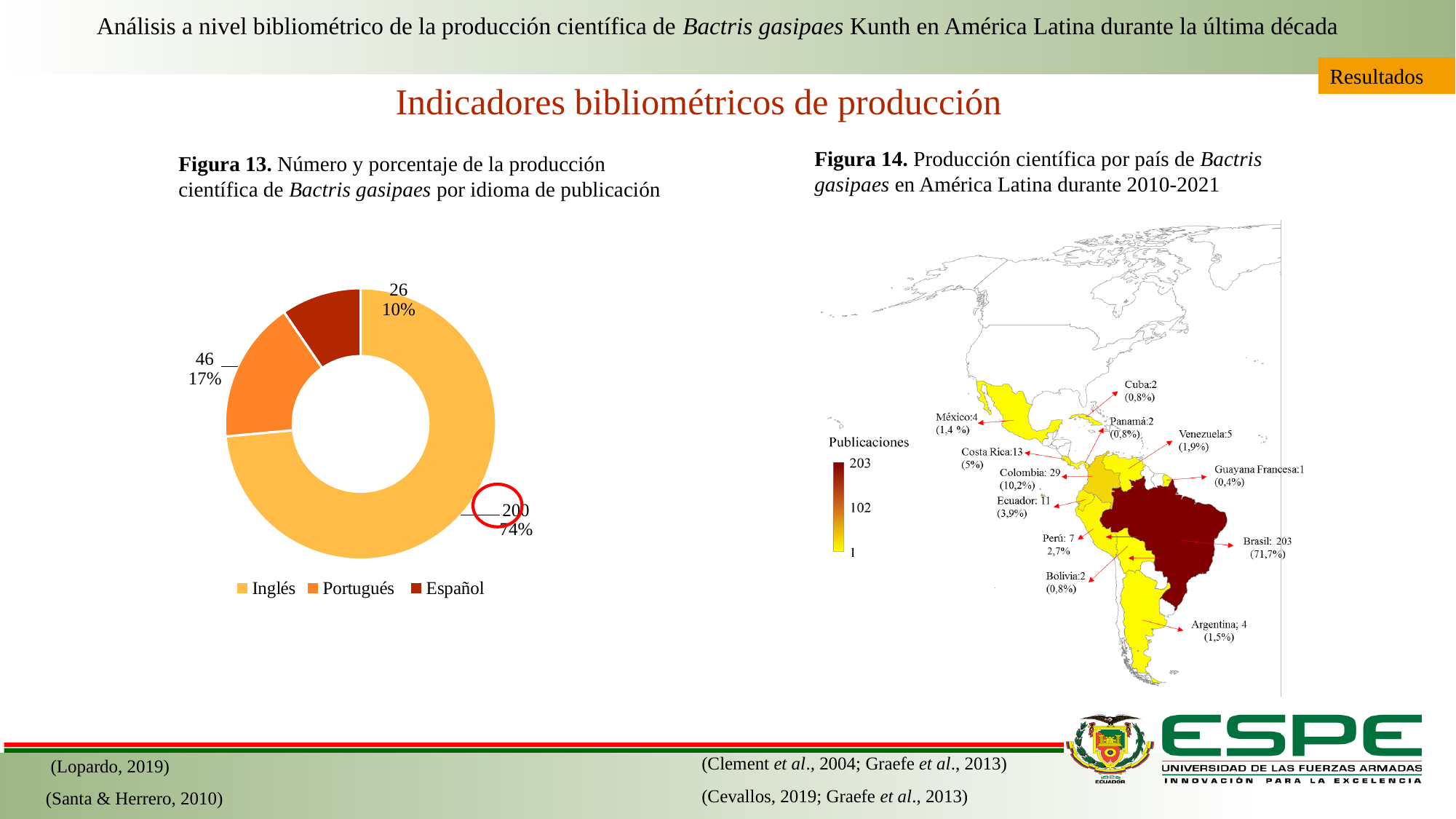
In Figura 13 (the donut chart), which language has the smallest number of publications? Español In Figura 13 (the donut chart), how many publications are in Español? 26 In Figura 13 (the donut chart), how many publications are in Inglés? 200 In Figura 13 (the donut chart), which has more publications, Portugués or Español? Portugués What type of chart is Figura 13? Donut (pie) chart In Figura 14 (the map), which country has the highest number of publications? Brasil In Figura 13 (the donut chart), what percentage of the production is in Portugués? 17% In Figura 13 (the donut chart), which language has the largest share of publications? Inglés In Figura 14 (the map), what percentage of publications corresponds to Colombia? 10,2% In Figura 13 (the donut chart), what is the difference between the number of publications in Inglés and in Portugués? 154 In Figura 13 (the donut chart), how many languages are shown in the legend? 3 In Figura 14 (the map), how many publications are attributed to Brasil? 203